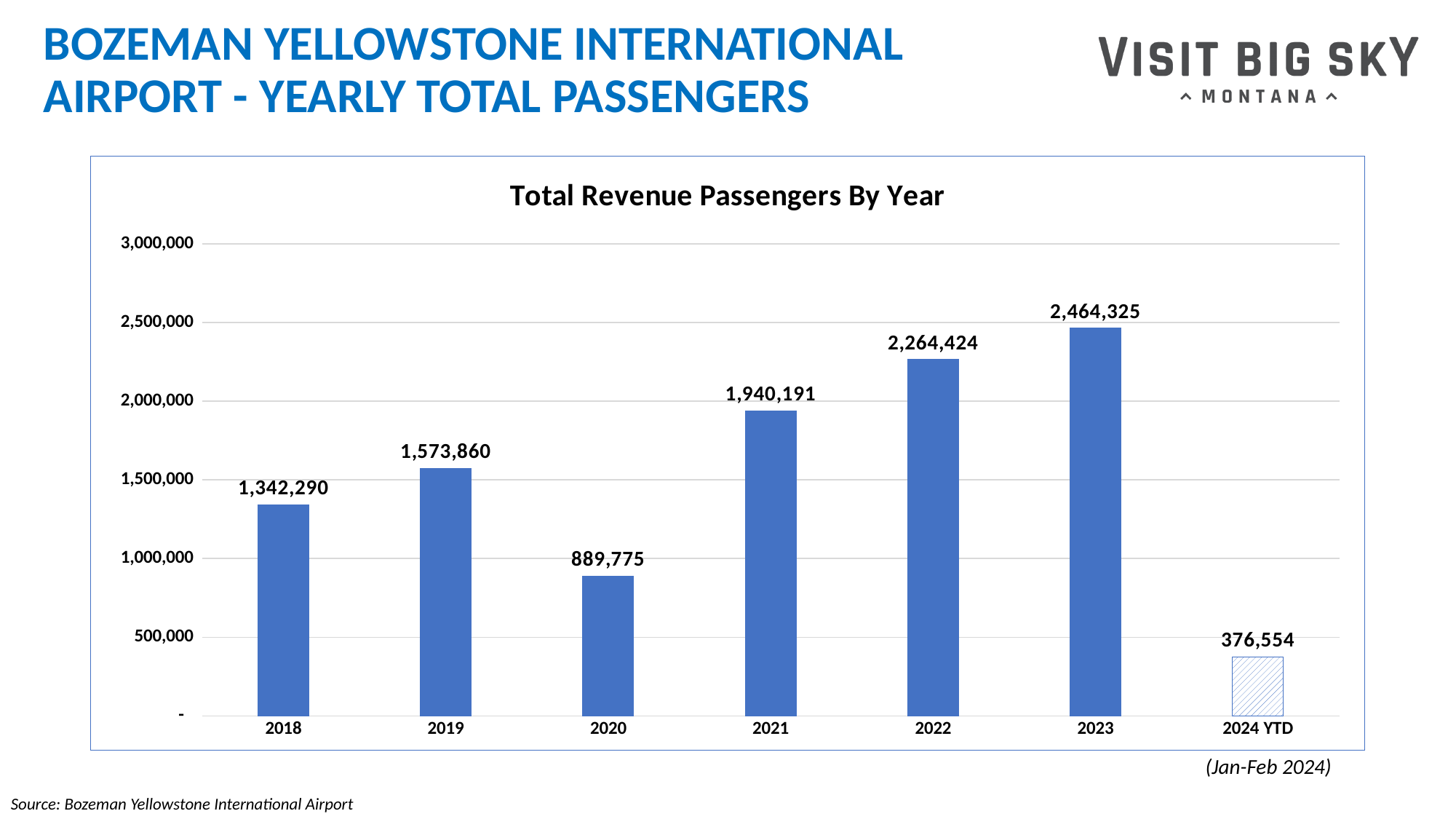
Is the value for 2020 greater or less than 1,000,000? less How many categories are shown on the x axis? 7 What is the total revenue passengers value for 2021? 1,940,191 What is the difference in passengers between 2019 and 2018? 231,570 Which year has the highest total revenue passengers? 2023 Which year had more passengers, 2019 or 2021? 2021 What is the difference in passengers between 2023 and 2022? 199,901 What kind of chart is shown on the slide? bar chart What is the total revenue passengers value for 2020? 889,775 What is the value shown for 2024 YTD? 376,554 What is the title of the chart? Total Revenue Passengers By Year Which category has the lowest value on the chart? 2024 YTD